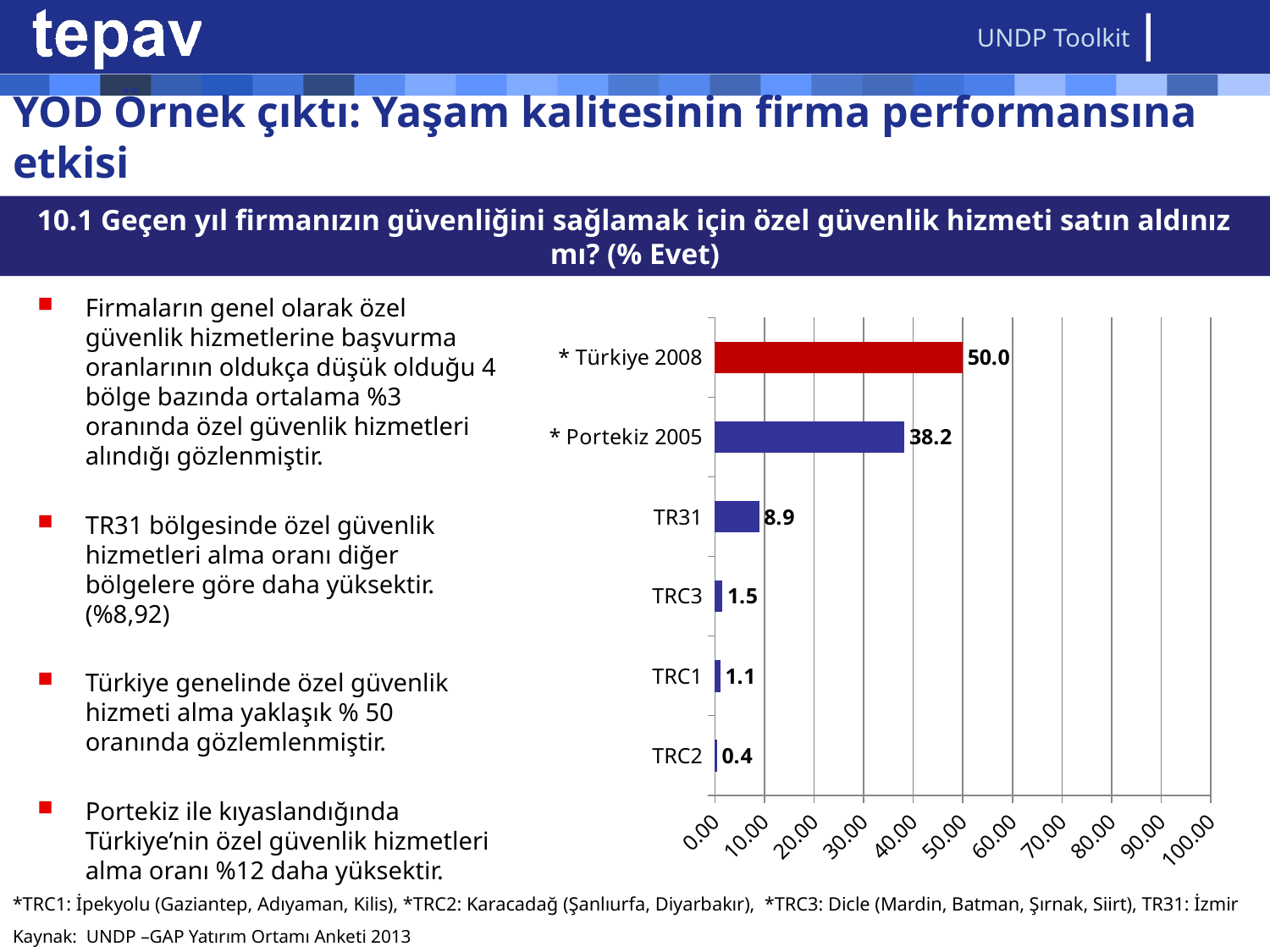
Which category has the highest value? * Türkiye 2008 What is the value for * Portekiz 2005? 38.2 Which category has the lowest value? TRC2 Is the value for * Portekiz 2005 greater or less than 30.00? greater What is the difference between the values for * Türkiye 2008 and * Portekiz 2005? 11.8 What is the value for TR31? 8.9 What is the value for * Türkiye 2008? 50.0 What kind of chart is shown on the slide? bar chart Which is larger, the value for TRC3 or the value for TRC1? TRC3 What is the value for TRC2? 0.4 Which bar is coloured red rather than blue? * Türkiye 2008 How many categories are shown in the chart? 6